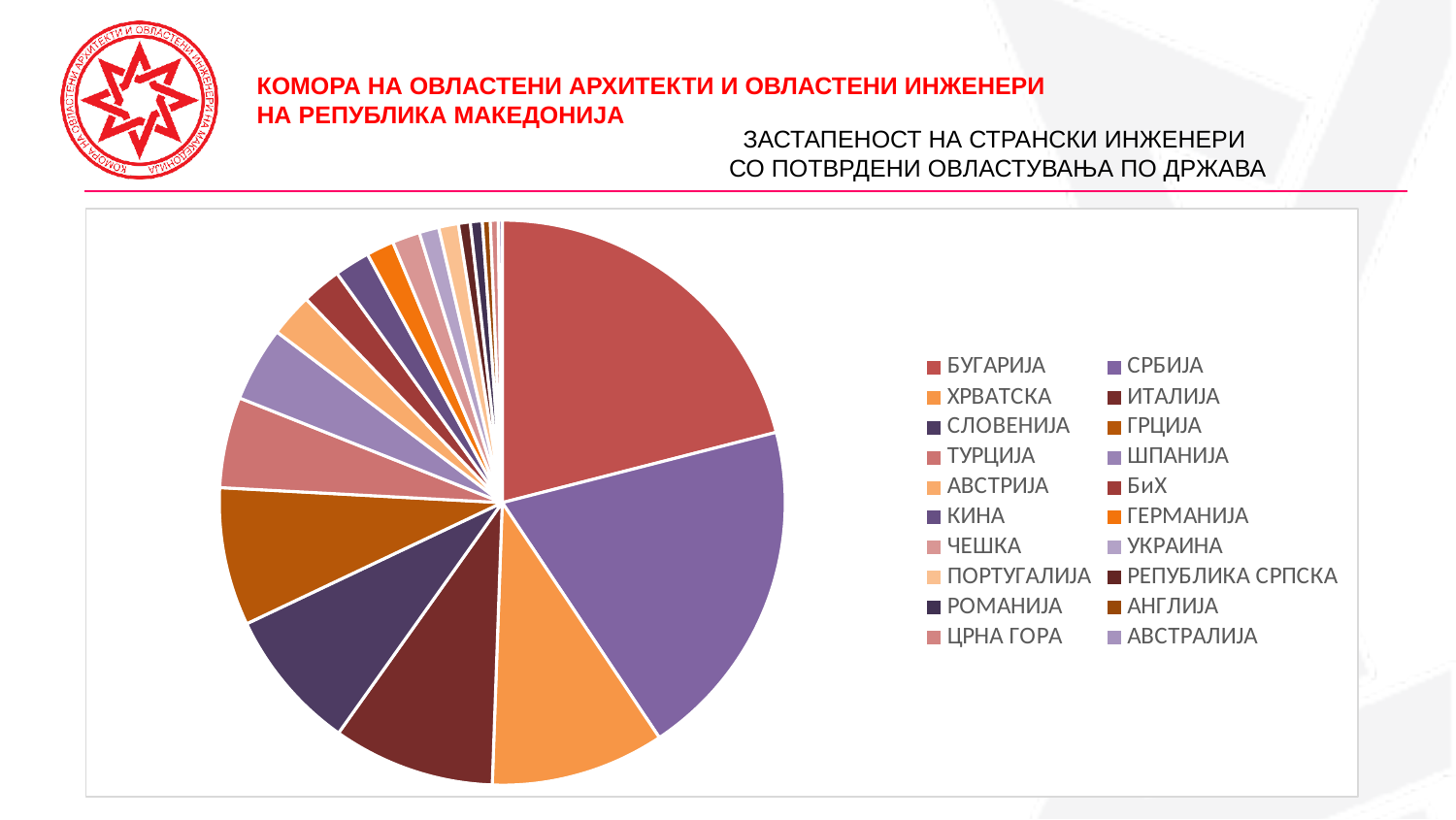
How many countries (categories) does the legend of the pie chart list? 20 Which slice is larger in the pie chart, БУГАРИЈА or АНГЛИЈА? БУГАРИЈА What is the title of the chart on the slide? ЗАСТАПЕНОСТ НА СТРАНСКИ ИНЖЕНЕРИ СО ПОТВРДЕНИ ОВЛАСТУВАЊА ПО ДРЖАВА Which slice is larger in the pie chart, СЛОВЕНИЈА or ТУРЦИЈА? СЛОВЕНИЈА Which country is listed first in the chart's legend? БУГАРИЈА Which slice is larger in the pie chart, ГРЦИЈА or ШПАНИЈА? ГРЦИЈА Which country has the largest slice in the pie chart? БУГАРИЈА What kind of chart is shown on the slide? Pie chart